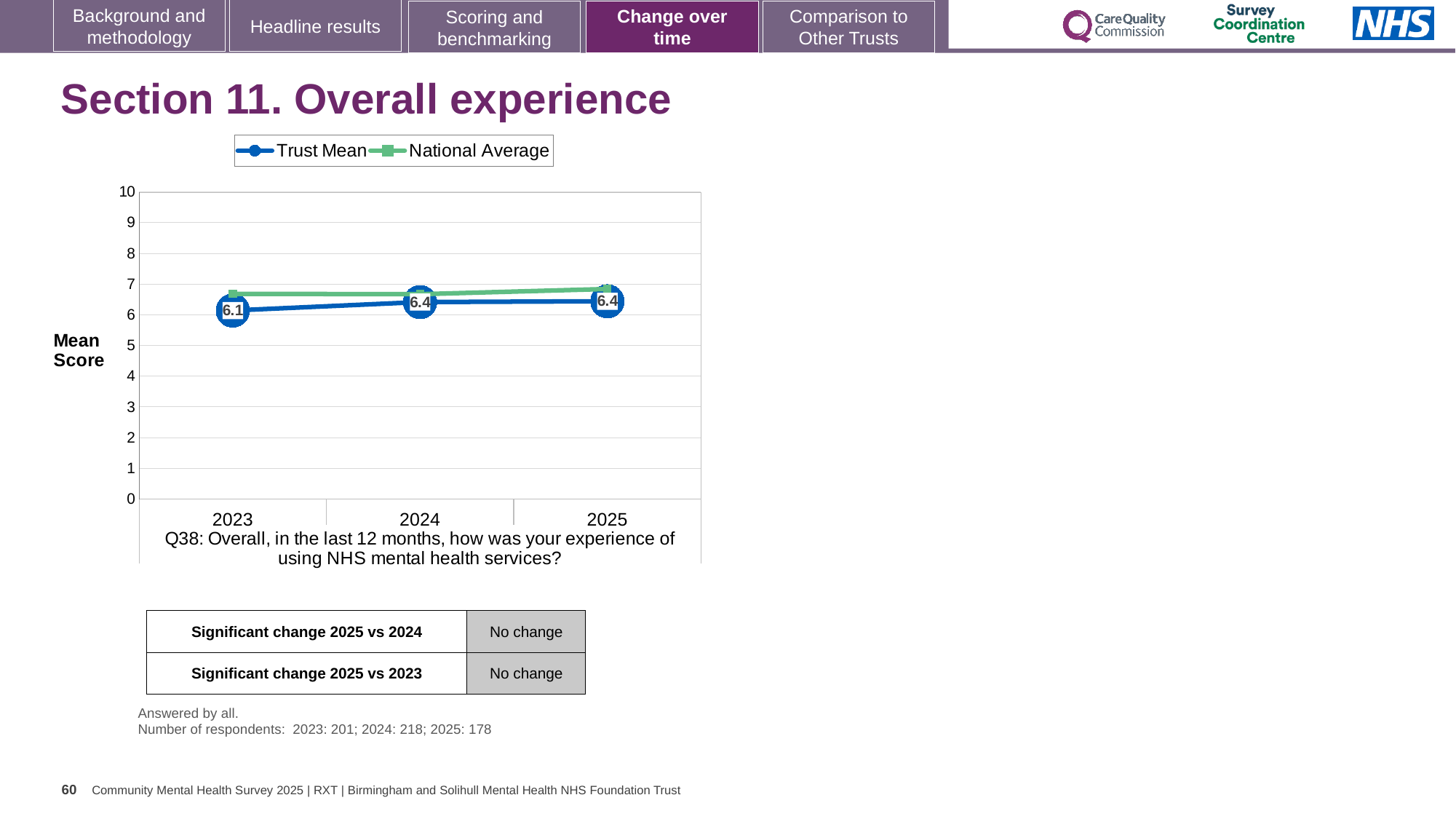
What is the Trust Mean score for 2025? 6.4 What is the Trust Mean score for 2024? 6.4 How many years are plotted on the x axis? 3 How many series does the legend list? 2 In 2023, which is higher: the Trust Mean or the National Average? National Average What is the Trust Mean score for 2023? 6.1 What kind of chart is shown? Line chart Is the National Average for 2023 greater or less than 6? greater In which year is the Trust Mean lowest? 2023 Does the Trust Mean rise or fall from 2023 to 2024? Rise Is the National Average for 2025 greater or less than 7? less What is the difference between the Trust Mean in 2024 and in 2023? 0.3